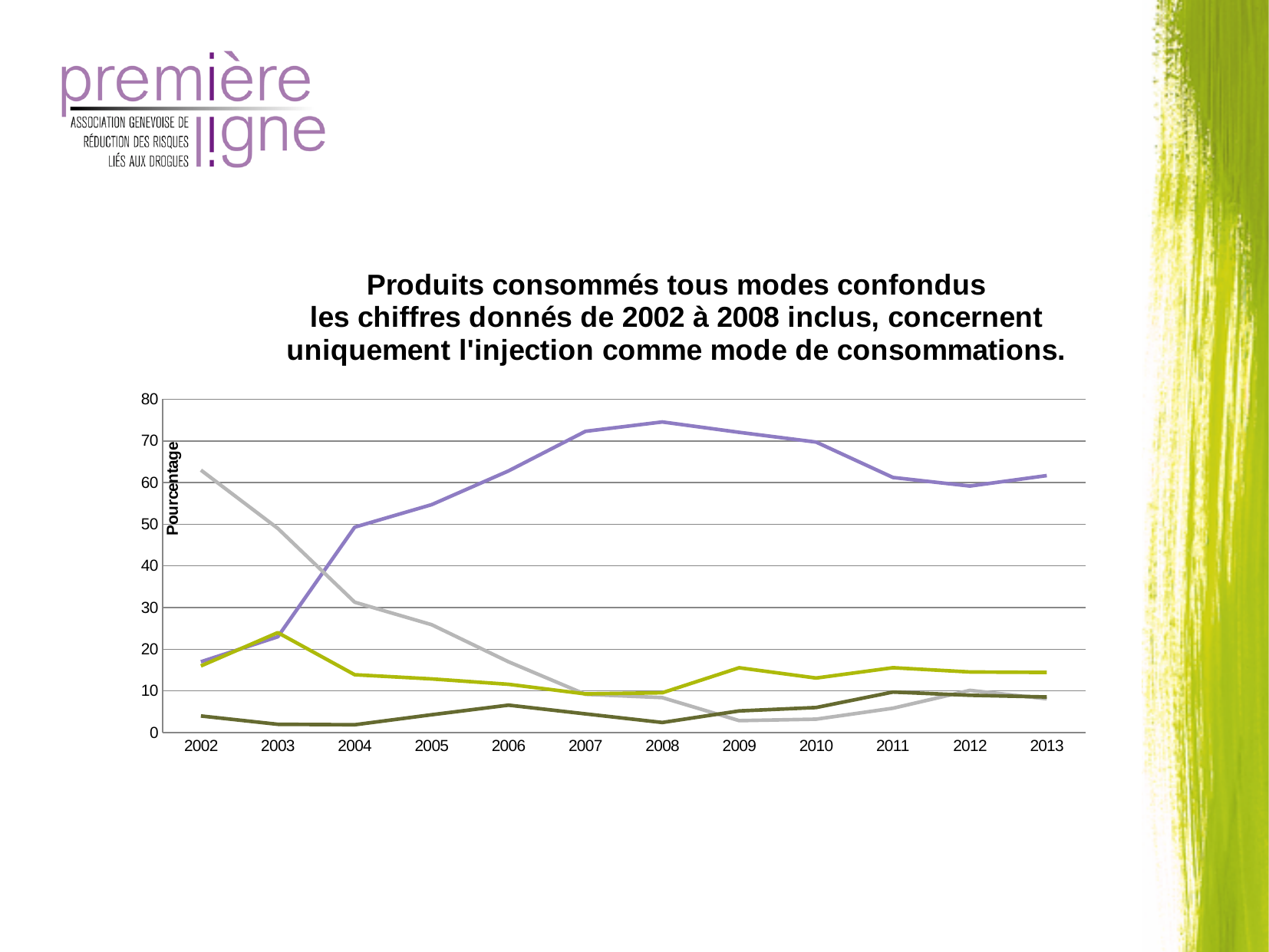
Is the value of the grey line in 2005 greater or less than 30? less In 2002, which line has the larger value, the grey line or the purple line? the grey line How many years are shown along the x axis of the chart? 12 Is the value of the grey line in 2002 greater or less than 60? greater Does the purple line rise or fall between 2002 and 2008? rise Does the grey line rise or fall between 2002 and 2009? fall What is the label of the vertical axis of the chart? Pourcentage Is the value of the purple line in 2008 greater or less than 70? greater What kind of chart is shown on the slide? line chart What is the highest value shown on the vertical axis of the chart? 80